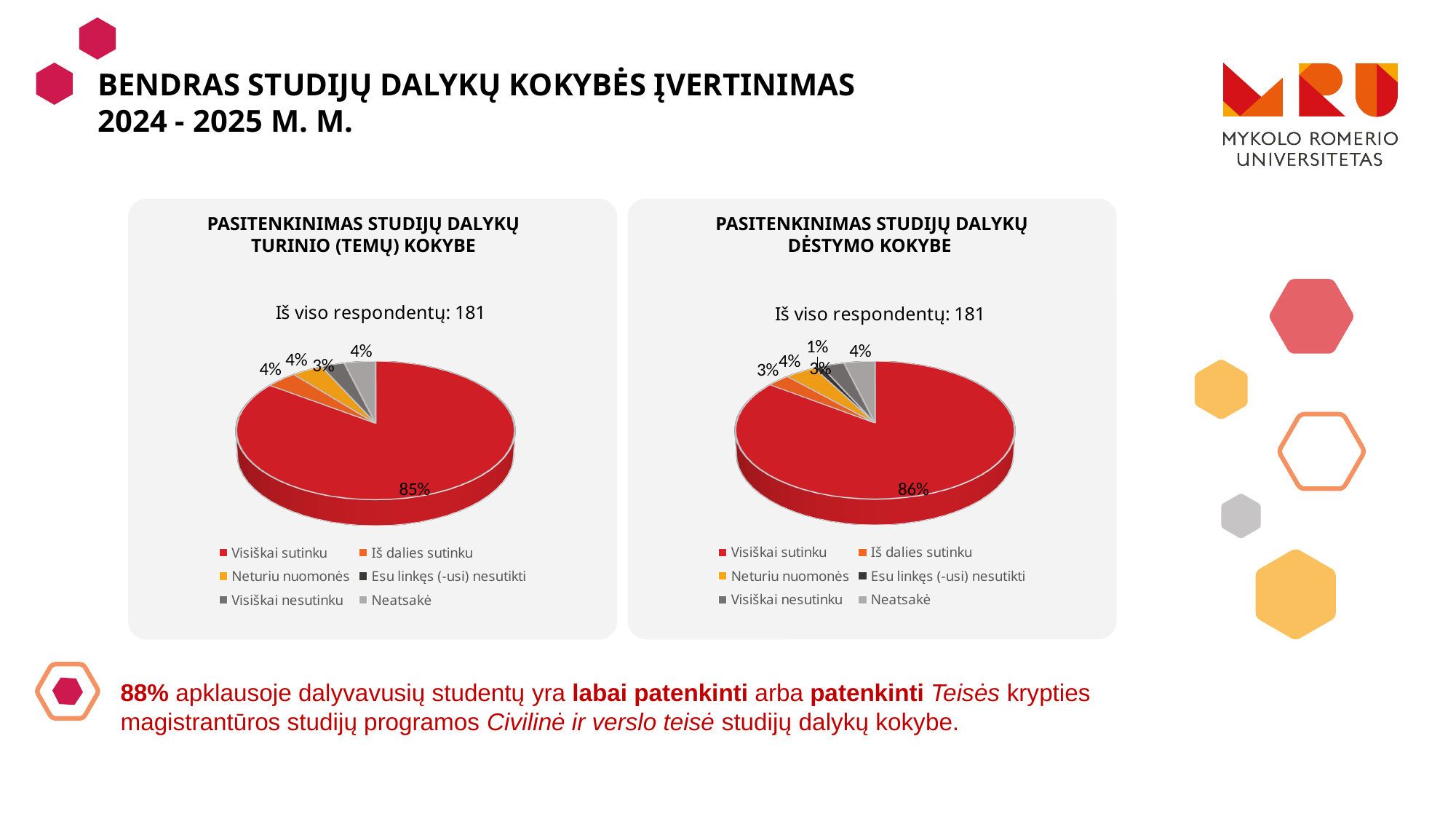
In the left chart (Pasitenkinimas studijų dalykų turinio (temų) kokybe), which answer has the largest slice? Visiškai sutinku In the right chart (Pasitenkinimas studijų dalykų dėstymo kokybe), what share of respondents answered "Visiškai nesutinku"? 3% What is the difference in percentage points between the "Visiškai sutinku" share in the right chart (86%) and in the left chart (85%)? 1 percentage point In the left chart (Pasitenkinimas studijų dalykų turinio (temų) kokybe), what share of respondents answered "Visiškai sutinku"? 85% How many entries does the legend of the left chart (Pasitenkinimas studijų dalykų turinio (temų) kokybe) list? 6 Which chart shows a larger share for "Visiškai sutinku": the left chart (turinio kokybe) or the right chart (dėstymo kokybe)? The right chart (dėstymo kokybe) In the right chart (Pasitenkinimas studijų dalykų dėstymo kokybe), which answer has the smallest labelled slice? Esu linkęs (-usi) nesutikti How many respondents in total are reported for the right chart (Pasitenkinimas studijų dalykų dėstymo kokybe)? 181 What type of chart is used on this slide? Pie chart In the right chart (Pasitenkinimas studijų dalykų dėstymo kokybe), what share of respondents answered "Neturiu nuomonės"? 4% In the right chart (Pasitenkinimas studijų dalykų dėstymo kokybe), what share of respondents answered "Visiškai sutinku"? 86%